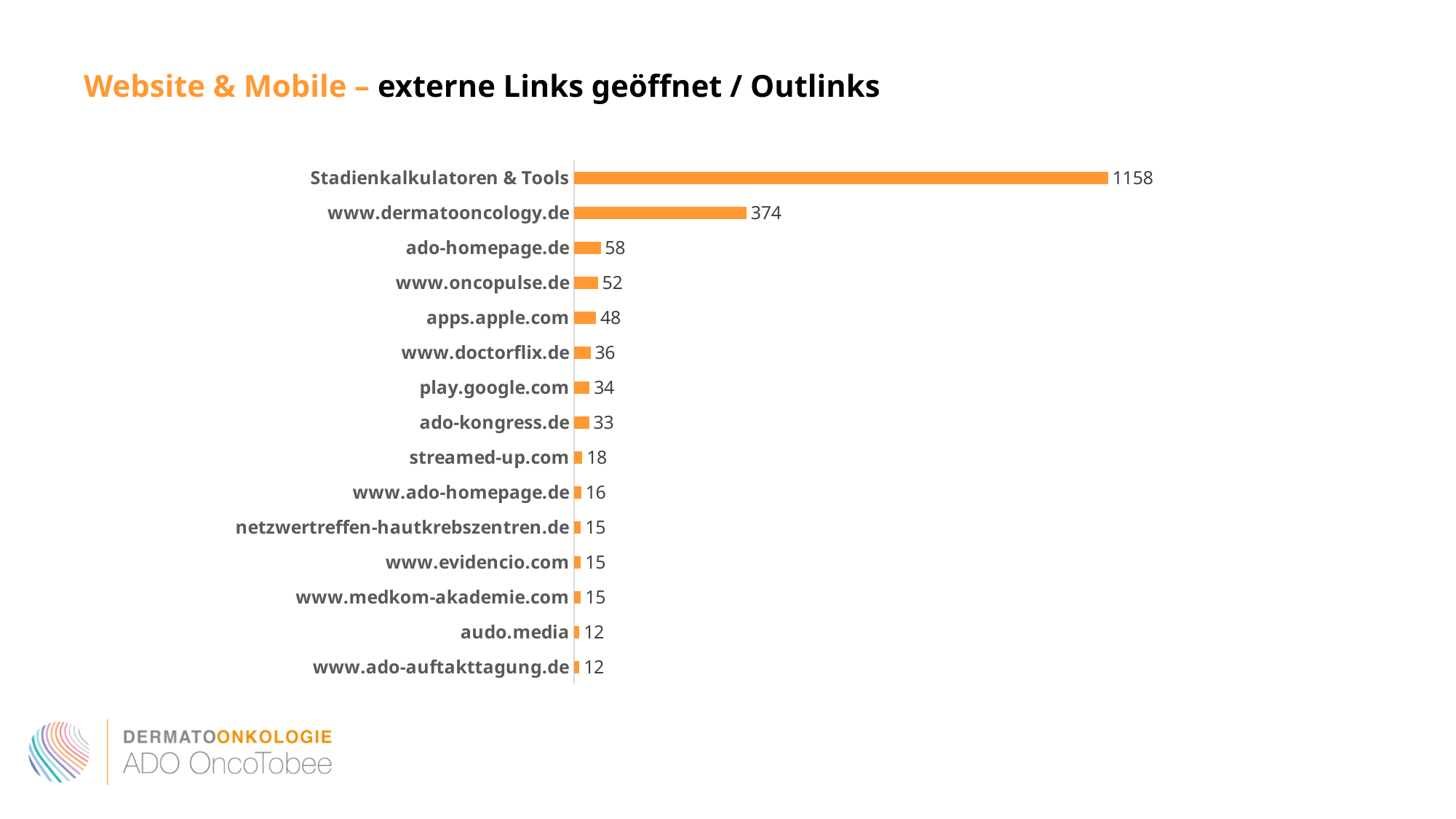
What is the difference between the values for ado-homepage.de and www.oncopulse.de? 6 What is the value for play.google.com? 34 What is the value for www.ado-auftakttagung.de? 12 How many categories are shown in the chart? 15 What is the difference between the values for Stadienkalkulatoren & Tools and www.dermatooncology.de? 784 What is the value for www.dermatooncology.de? 374 What colour are the bars in the chart? Orange What is the value for apps.apple.com? 48 What kind of chart is shown on the slide? Bar chart Which is larger, the value for www.doctorflix.de or the value for streamed-up.com? www.doctorflix.de What is the value for Stadienkalkulatoren & Tools? 1158 Which category has the highest value? Stadienkalkulatoren & Tools